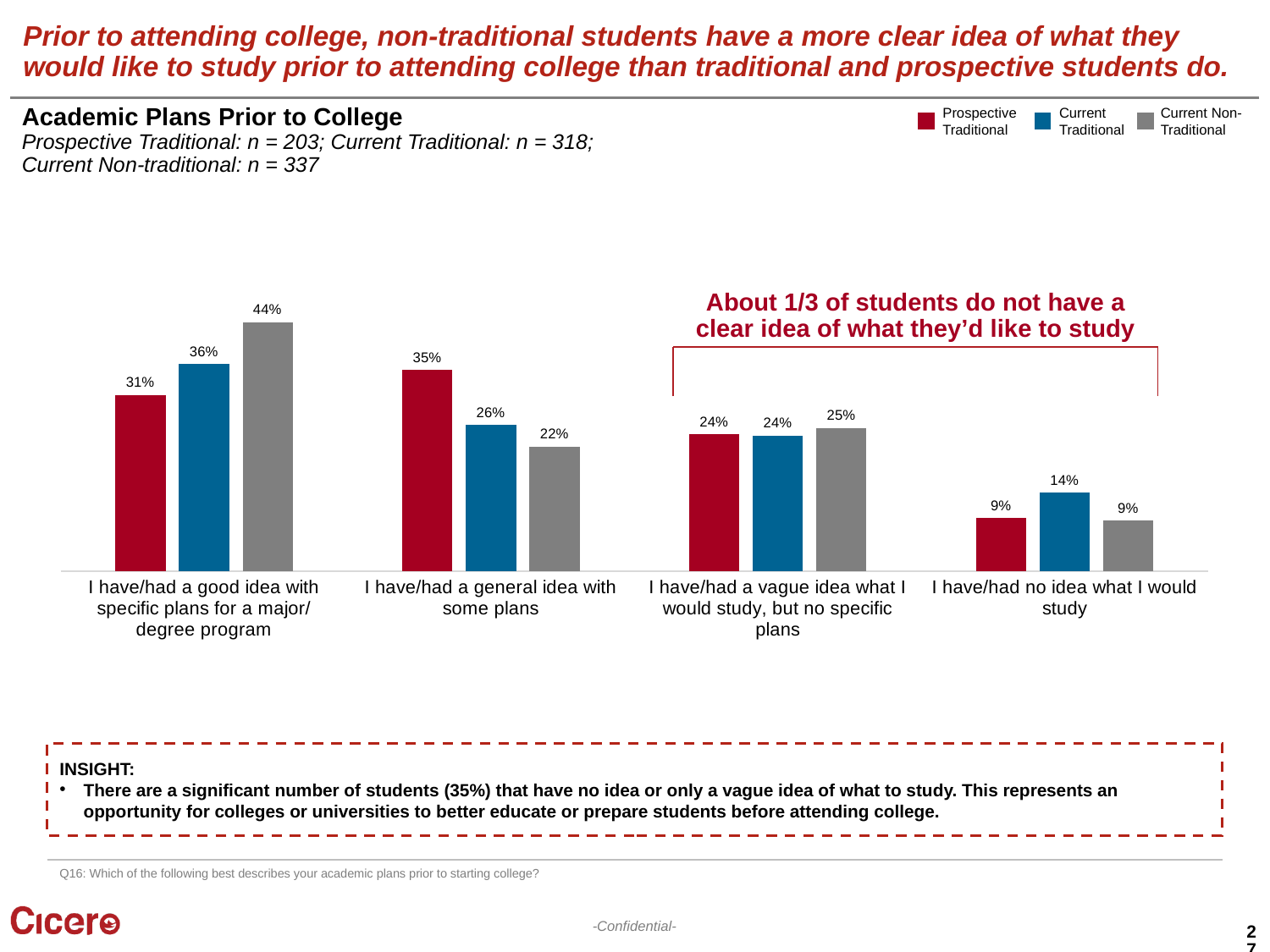
What kind of chart is shown on the slide? Bar chart Which category has the highest value for Current Non-Traditional students? I have/had a good idea with specific plans for a major/degree program What is the value for Prospective Traditional students in the 'I have/had a general idea with some plans' category? 35% What is the title of the chart? Academic Plans Prior to College How many series does the legend list? 3 In the 'I have/had a general idea with some plans' category, which is larger: the Prospective Traditional value or the Current Non-Traditional value? Prospective Traditional What is the value for Current Traditional students in the 'I have/had no idea what I would study' category? 14% What is the value for Current Non-Traditional students in the 'I have/had a good idea with specific plans for a major/degree program' category? 44% How many categories are shown on the x axis of the chart? 4 What is the difference between the Current Non-Traditional and Prospective Traditional values in the 'I have/had a good idea with specific plans for a major/degree program' category? 13% Which category has the lowest value for Prospective Traditional students? I have/had no idea what I would study Which colour represents Current Traditional students in the chart? Blue